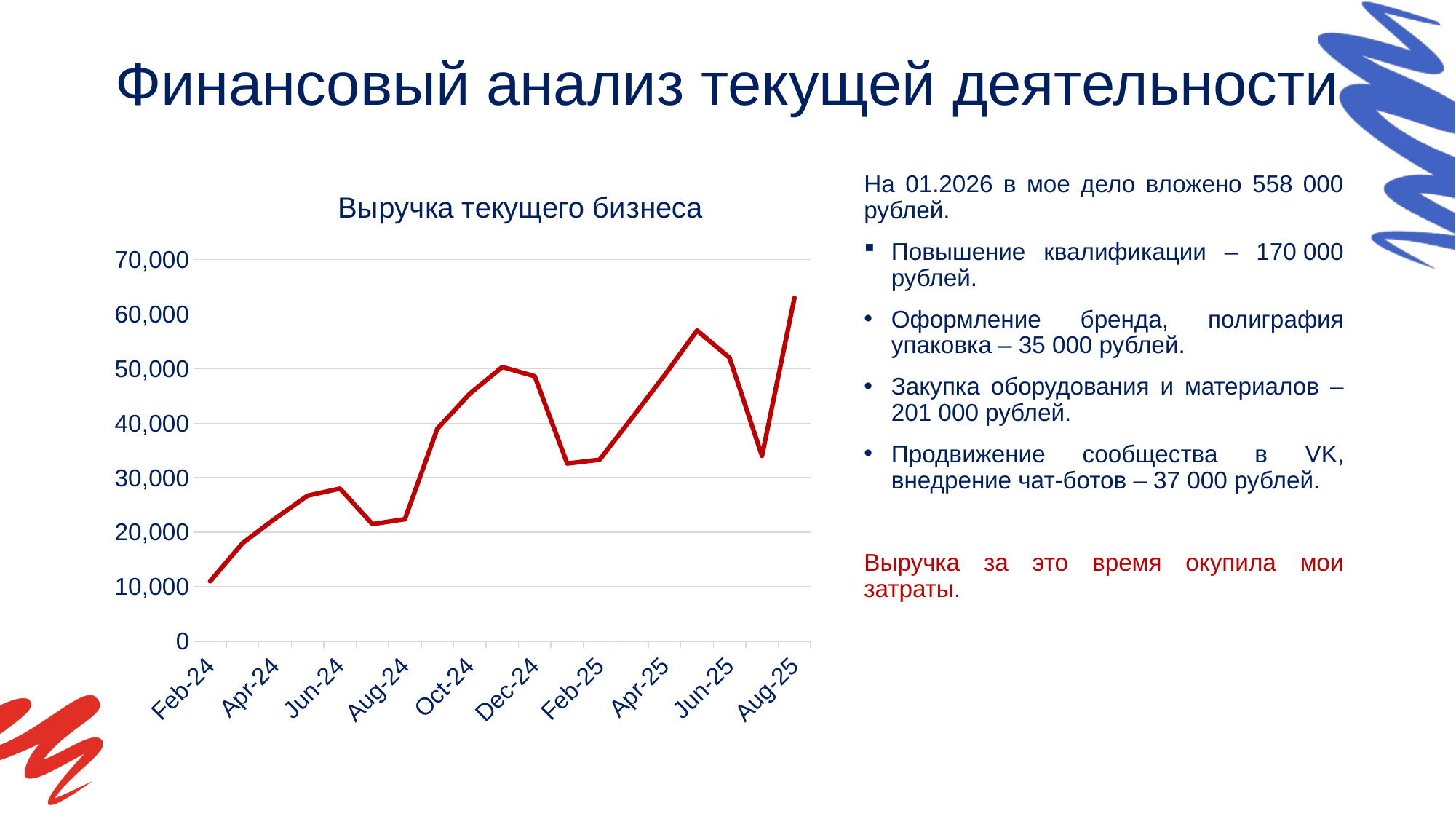
Is the value for Feb-25 greater or less than 40,000? less What is the title of the chart? Выручка текущего бизнеса Is the value for Oct-24 greater or less than 30,000? greater Overall, do the values rise or fall from Feb-24 to Aug-25? rise Is the value for Dec-24 greater or less than 40,000? greater Which is larger, the value for Dec-24 or the value for Feb-25? Dec-24 Which month has the highest value on the chart? Aug-25 Which is larger, the value for Jun-25 or the value for Jun-24? Jun-25 What kind of chart is shown on the slide? line chart Which month has the lowest value on the chart? Feb-24